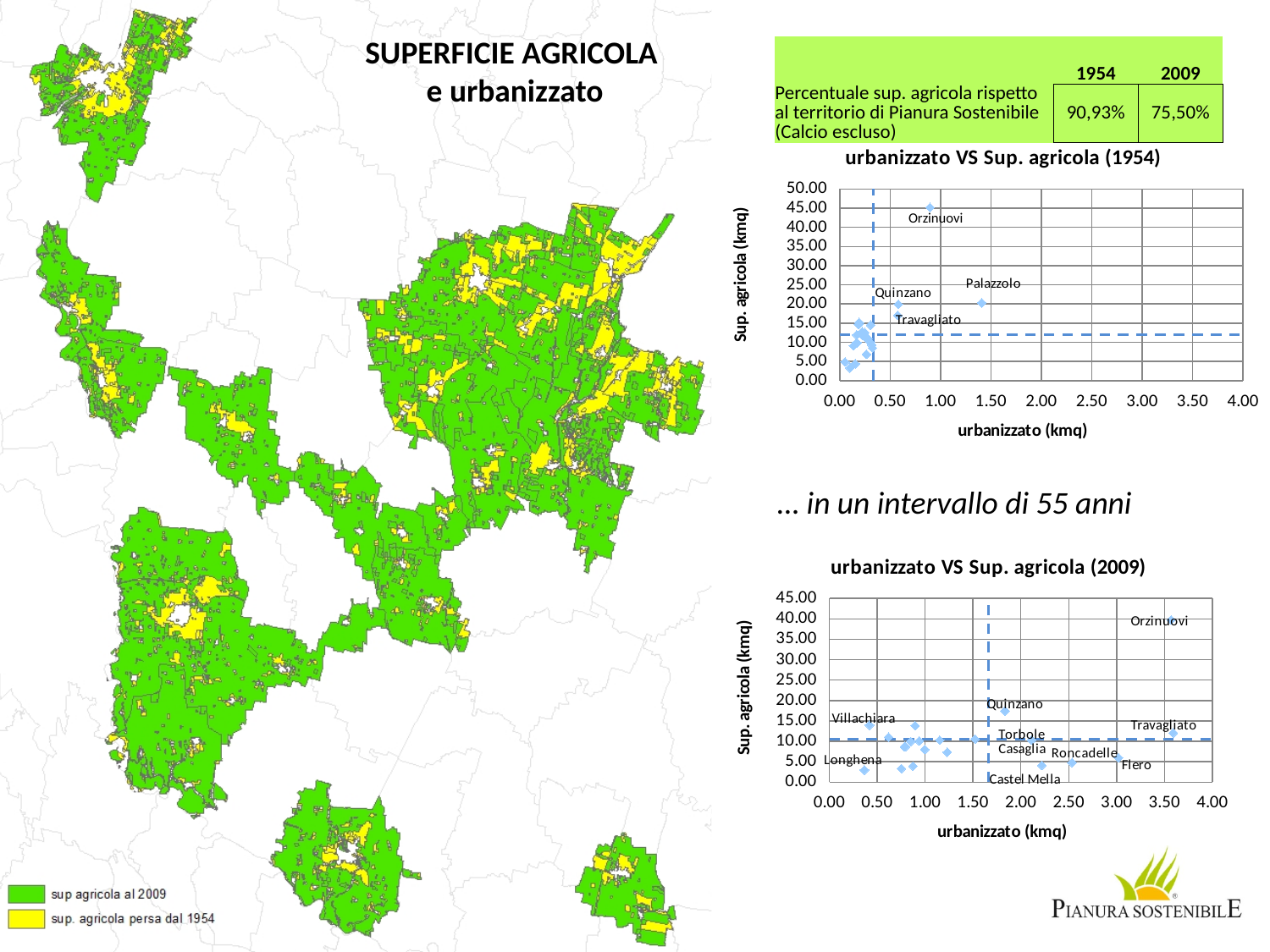
In the chart "urbanizzato VS Sup. agricola (2009)", which has the larger Sup. agricola value, Orzinuovi or Travagliato? Orzinuovi In the chart "urbanizzato VS Sup. agricola (2009)", which labelled municipality has the highest Sup. agricola value? Orzinuovi In the chart "urbanizzato VS Sup. agricola (1954)", is the urbanizzato value for Palazzolo greater or less than 1.00? greater What is the x-axis title of the chart "urbanizzato VS Sup. agricola (1954)"? urbanizzato (kmq) In the chart "urbanizzato VS Sup. agricola (1954)", which has the larger urbanizzato value, Palazzolo or Quinzano? Palazzolo In the chart "urbanizzato VS Sup. agricola (2009)", is the urbanizzato value for Villachiara greater or less than 1.00? less What kind of chart is "urbanizzato VS Sup. agricola (1954)"? scatter chart In the chart "urbanizzato VS Sup. agricola (2009)", is the urbanizzato value for Flero greater or less than 2.50? greater In the chart "urbanizzato VS Sup. agricola (1954)", which labelled municipality has the highest Sup. agricola value? Orzinuovi